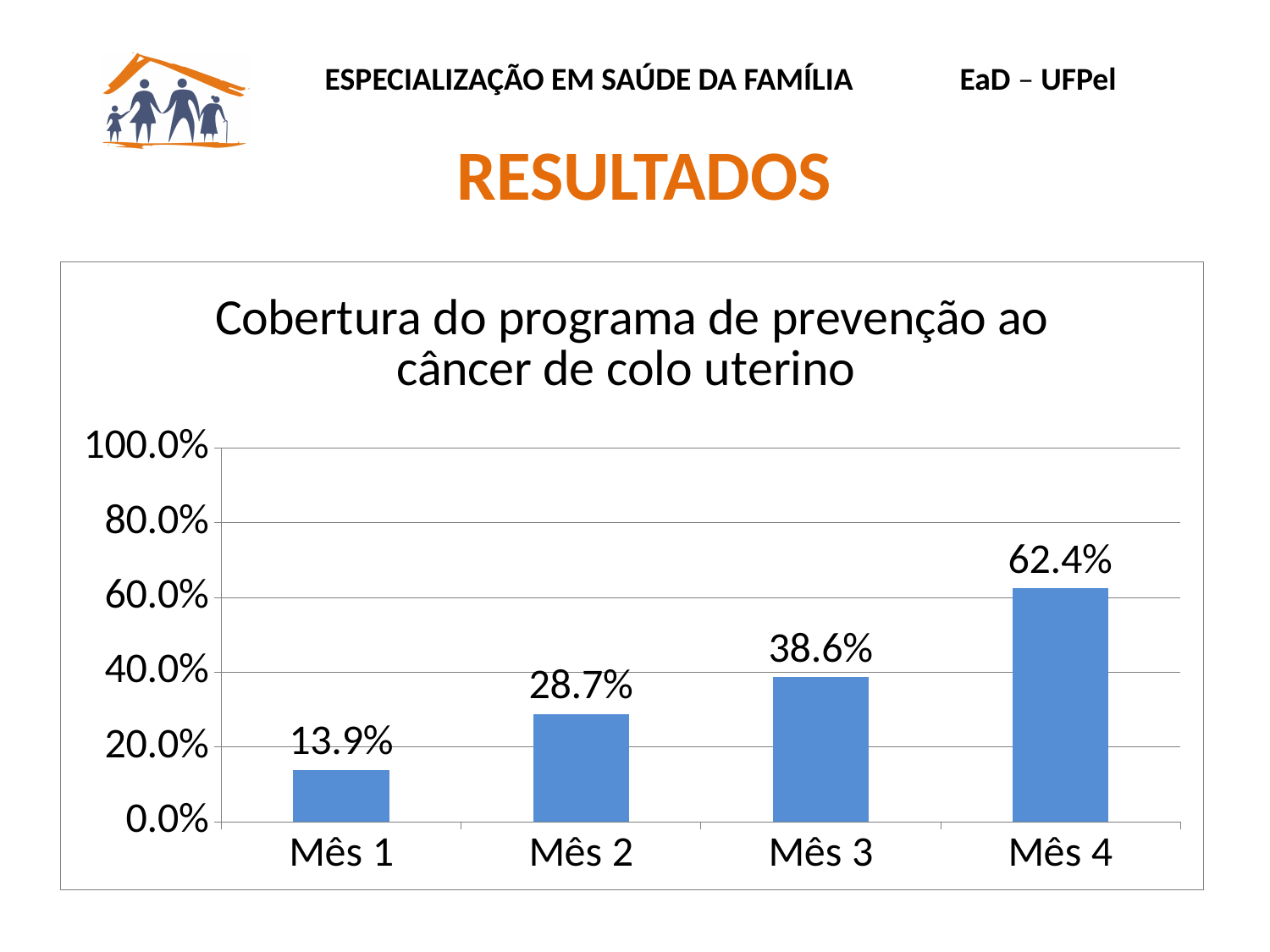
What kind of chart is this? bar chart What is the value for Mês 3? 38.6% Which month has the lowest coverage? Mês 1 What is the value for Mês 4? 62.4% What is the value for Mês 2? 28.7% What is the difference between the values for Mês 4 and Mês 1? 48.5% Which month has the highest coverage? Mês 4 What is the difference between the values for Mês 3 and Mês 2? 9.9% Is the value for Mês 4 greater or less than 60.0%? greater Which is larger, the value for Mês 2 or the value for Mês 3? Mês 3 How many months are shown on the x axis? 4 What is the value for Mês 1? 13.9%